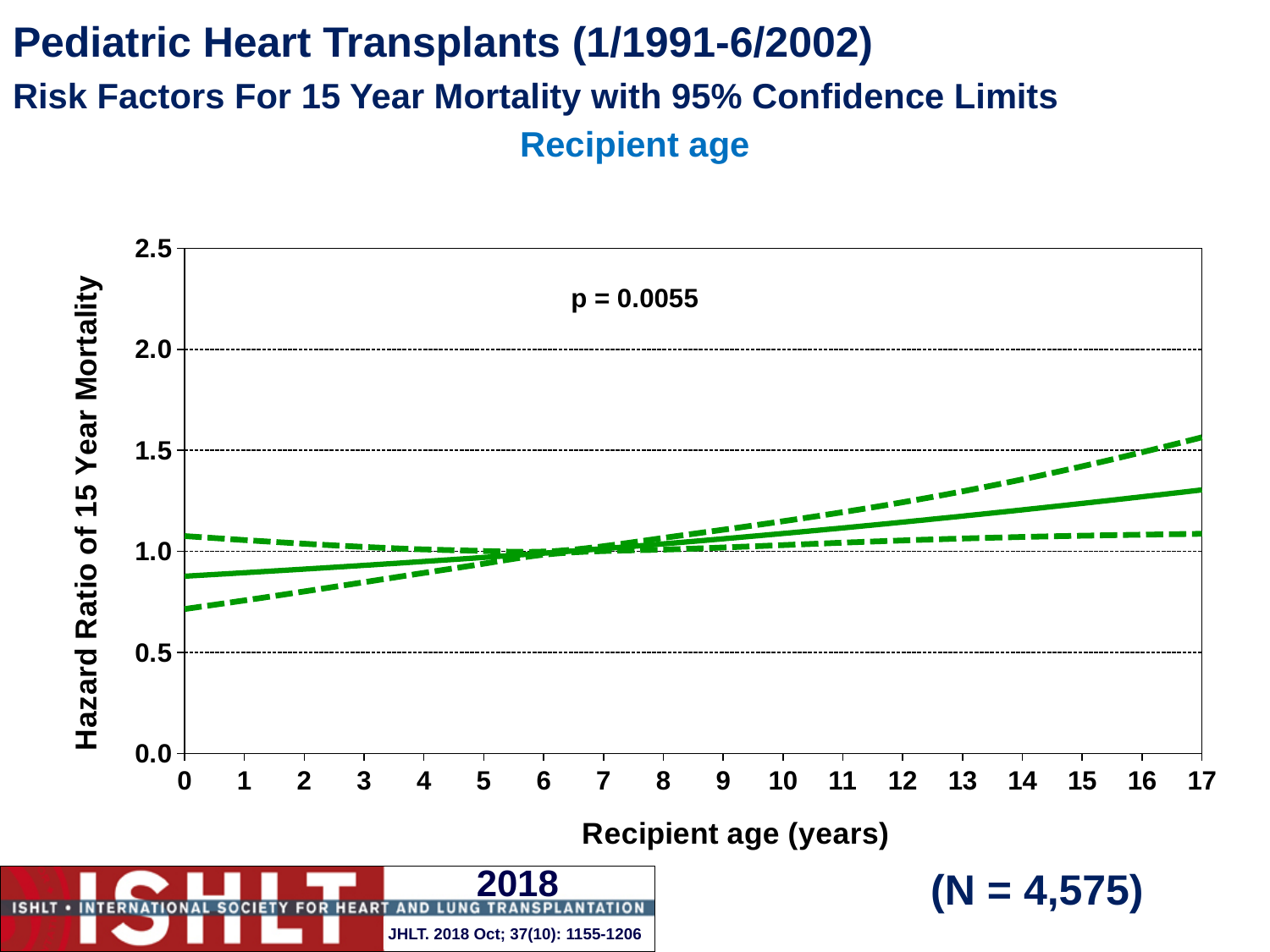
How many lines are plotted on the chart? 3 What p-value is printed on the chart? p = 0.0055 Is the upper 95% confidence limit (upper dashed line) at recipient age 17 greater or less than 1.0? greater Is the lower 95% confidence limit (lower dashed line) at recipient age 0 greater or less than 0.5? greater What kind of chart is shown on the slide? line chart Which is larger, the hazard ratio (solid line) at recipient age 0 or at recipient age 17? age 17 Is the hazard ratio (solid line) at recipient age 17 greater or less than 1.0? greater How many recipient age values are labeled on the x axis? 18 What is the sample size (N) shown on the slide? N = 4,575 Does the solid hazard ratio line rise or fall as recipient age increases from 0 to 17 years? rises